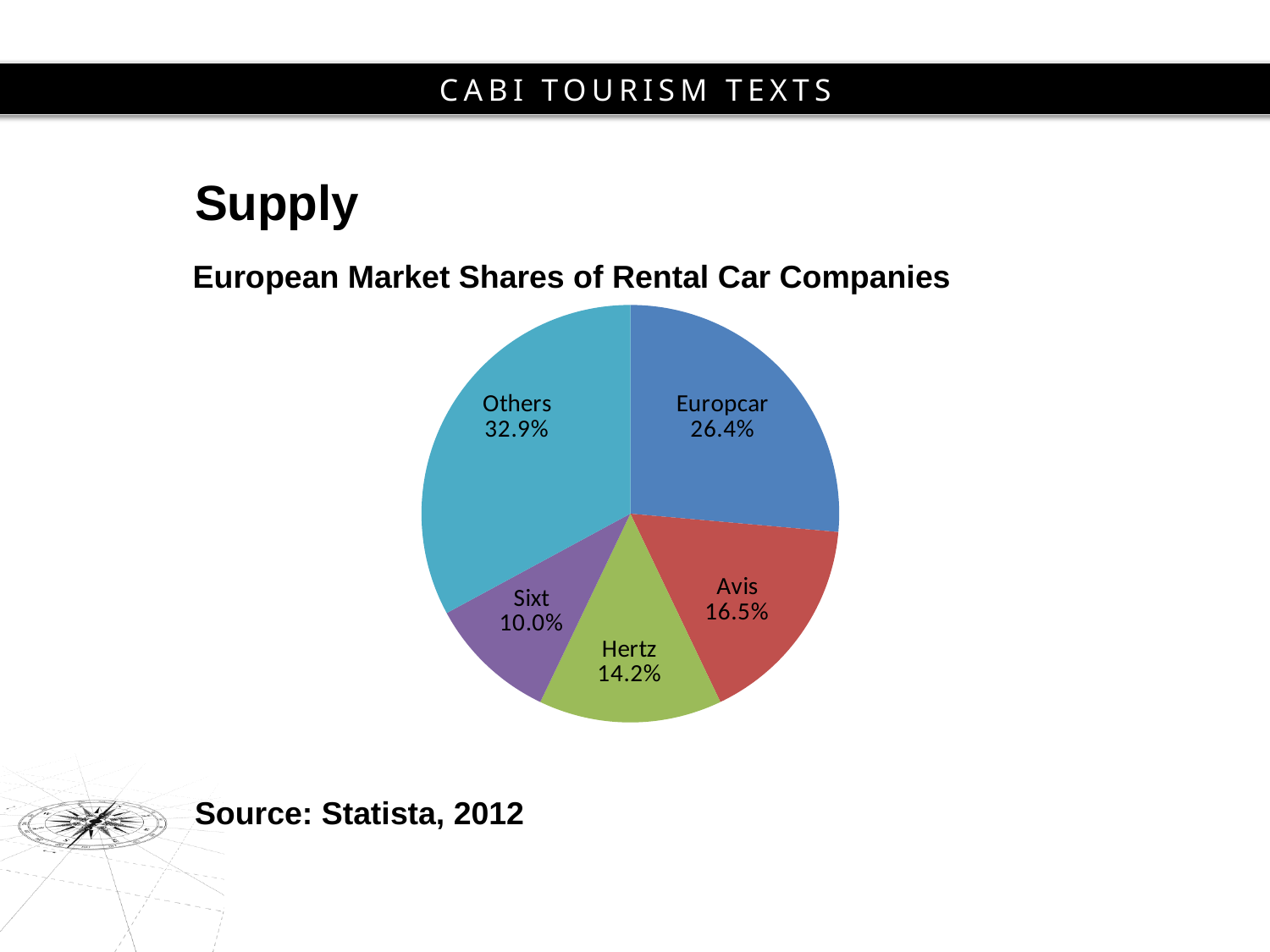
Which has a larger market share, Hertz or Sixt? Hertz What is the difference in market share between Europcar and Avis? 9.9% What is the market share of Hertz? 14.2% What kind of chart is shown on the slide? pie chart Which slice has the largest share of the pie? Others What is the title of the chart? European Market Shares of Rental Car Companies What is the market share of Sixt? 10.0% What is the market share of Europcar? 26.4% Which named rental car company has the smallest market share? Sixt What is the combined market share of Europcar and Avis? 42.9% How many slices does the pie chart have? 5 What is the market share of Avis? 16.5%